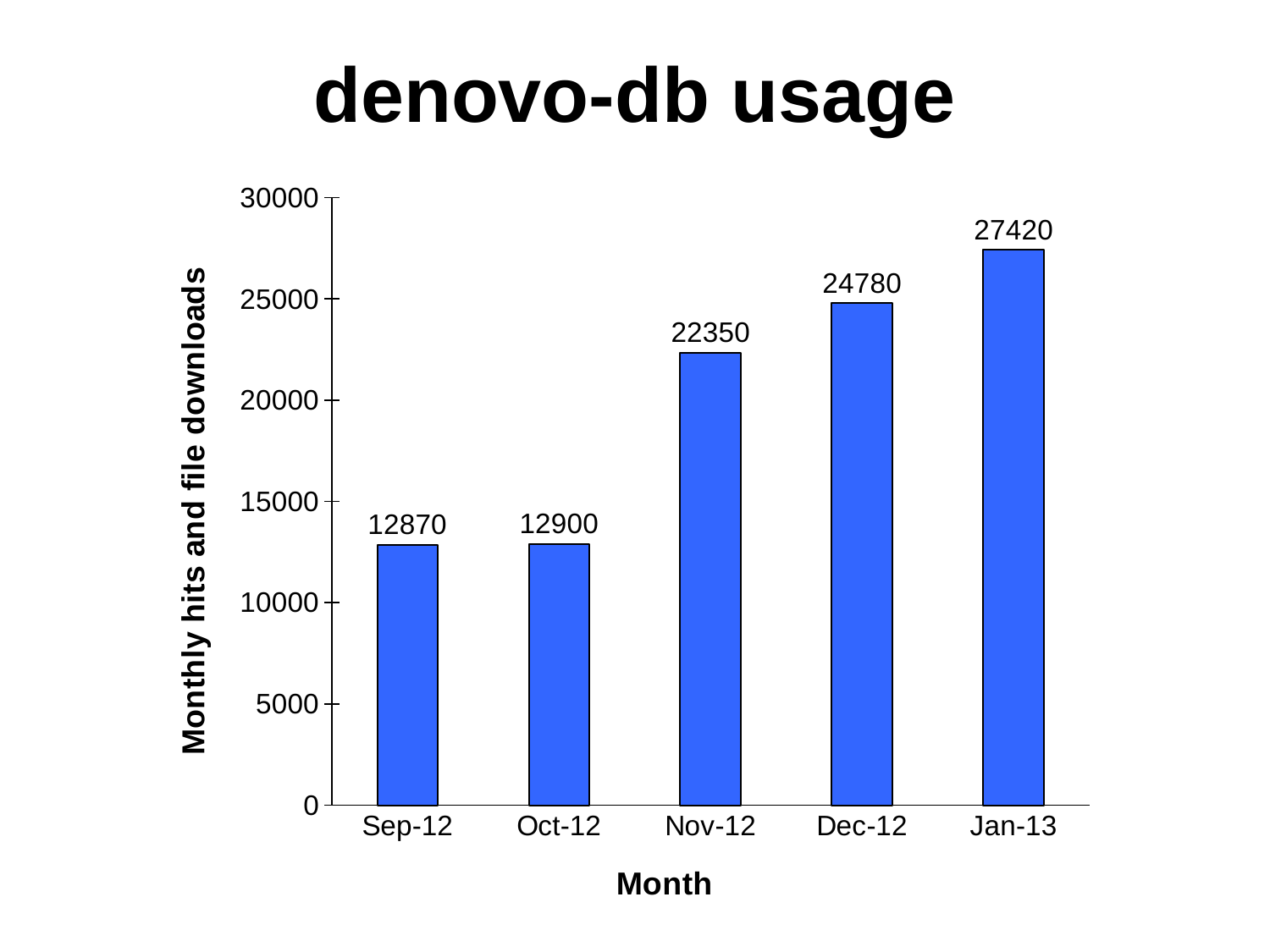
How many months are shown on the x axis? 5 What is the value for Jan-13? 27420 What is the value for Sep-12? 12870 What is the difference between the values for Nov-12 and Oct-12? 9450 What kind of chart is shown on the slide? bar chart What is the value for Nov-12? 22350 What is the difference between the values for Jan-13 and Dec-12? 2640 Which is larger, the value for Dec-12 or the value for Nov-12? Dec-12 Which month has the lowest value? Sep-12 Is the value for Dec-12 greater or less than 25000? less Do the values rise or fall from Sep-12 to Jan-13? rise Which month has the highest value? Jan-13